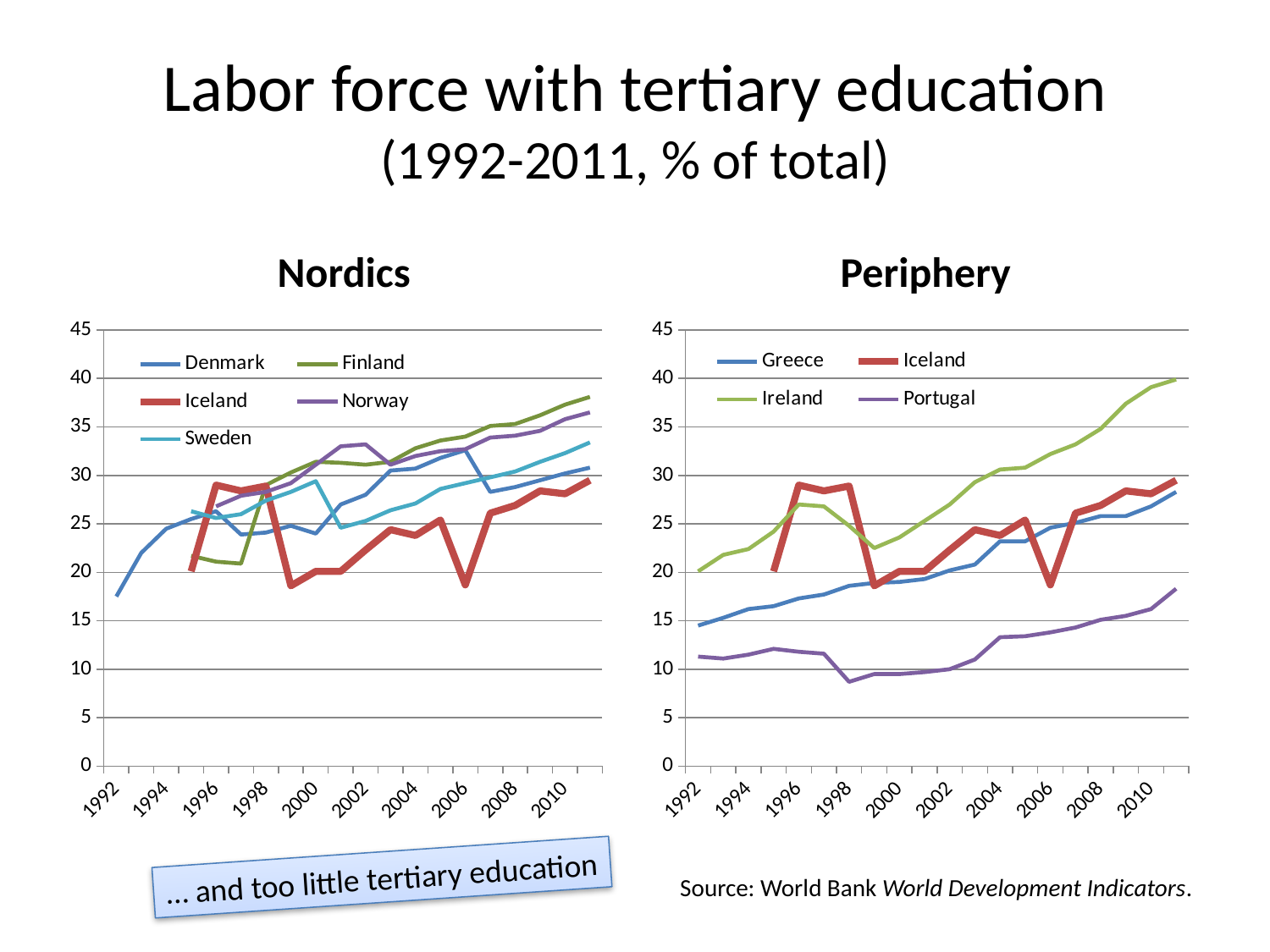
How many series does the legend of the Nordics chart list? 5 In the Periphery chart, which country has the lowest value in 2011? Portugal In the Periphery chart, is the value for Ireland in 2011 greater or less than 35? greater What source is cited for the data on the slide? World Bank World Development Indicators In the Nordics chart, is the value for Denmark in 1992 greater or less than 20? less In the Periphery chart, is the value for Portugal in 1998 greater or less than 10? less How many series does the legend of the Periphery chart list? 4 In the Nordics chart, which country has the highest value in 2011? Finland In the Periphery chart, which country has the highest value in 2011? Ireland What kind of chart is the Nordics chart? line chart In the Periphery chart, does the value for Greece generally rise or fall from 1992 to 2011? rise In the Periphery chart, which is larger in 2011, Ireland or Greece? Ireland